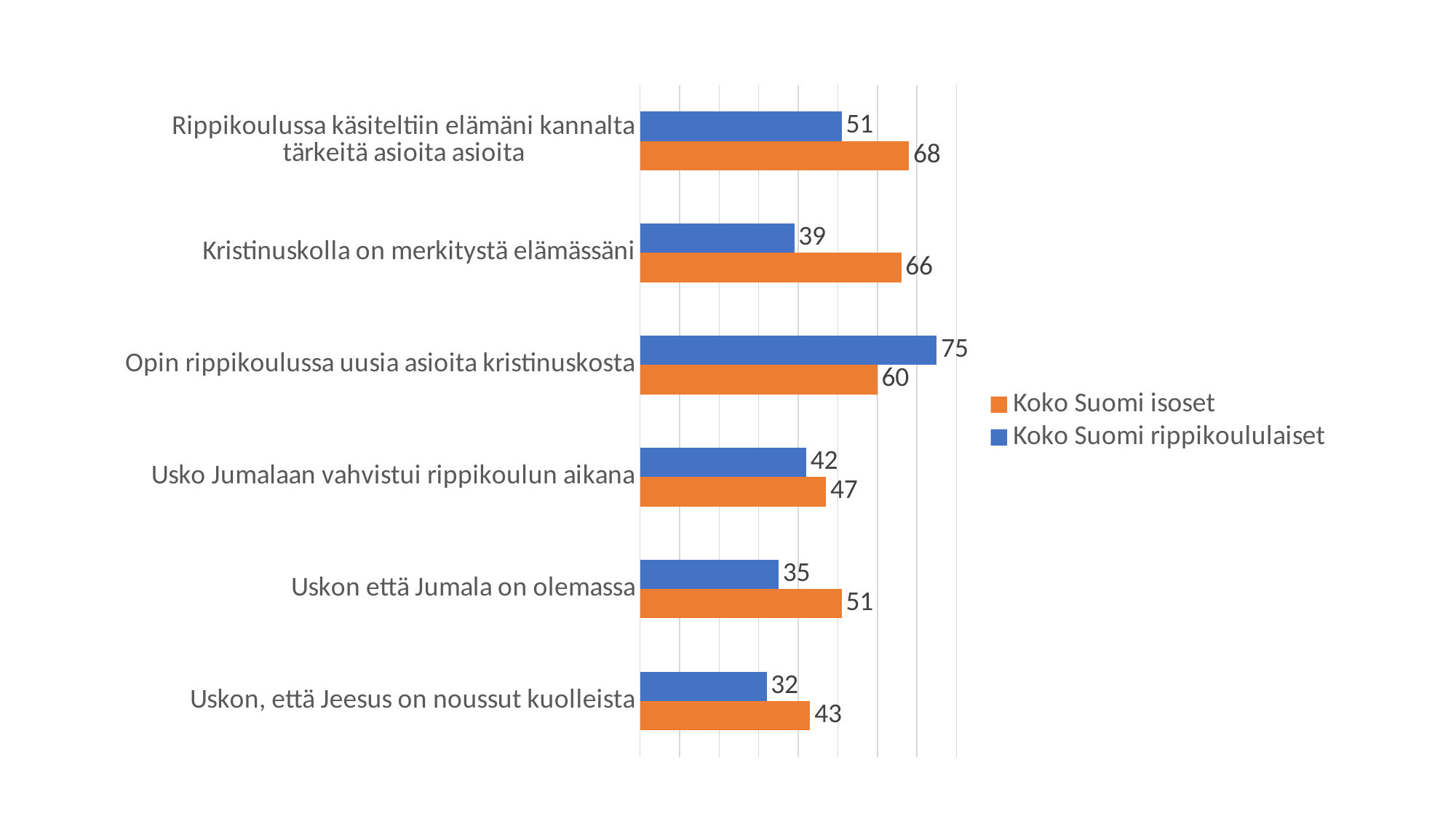
What is the value for "Koko Suomi isoset" for "Kristinuskolla on merkitystä elämässäni"? 66 Which category has the highest value for "Koko Suomi isoset"? Rippikoulussa käsiteltiin elämäni kannalta tärkeitä asioita asioita What is the difference between the "Koko Suomi isoset" and "Koko Suomi rippikoululaiset" values for "Uskon että Jumala on olemassa"? 16 What is the value for "Koko Suomi rippikoululaiset" for "Opin rippikoulussa uusia asioita kristinuskosta"? 75 What is the difference between the "Koko Suomi isoset" and "Koko Suomi rippikoululaiset" values for "Kristinuskolla on merkitystä elämässäni"? 27 What is the value for "Koko Suomi rippikoululaiset" for "Uskon, että Jeesus on noussut kuolleista"? 32 Which colour represents the "Koko Suomi isoset" series? orange For "Opin rippikoulussa uusia asioita kristinuskosta", which series has the larger value, "Koko Suomi isoset" or "Koko Suomi rippikoululaiset"? Koko Suomi rippikoululaiset How many series does the legend list? 2 Which category has the lowest value for "Koko Suomi rippikoululaiset"? Uskon, että Jeesus on noussut kuolleista What type of chart is shown on the slide? bar chart How many categories are shown in the chart? 6